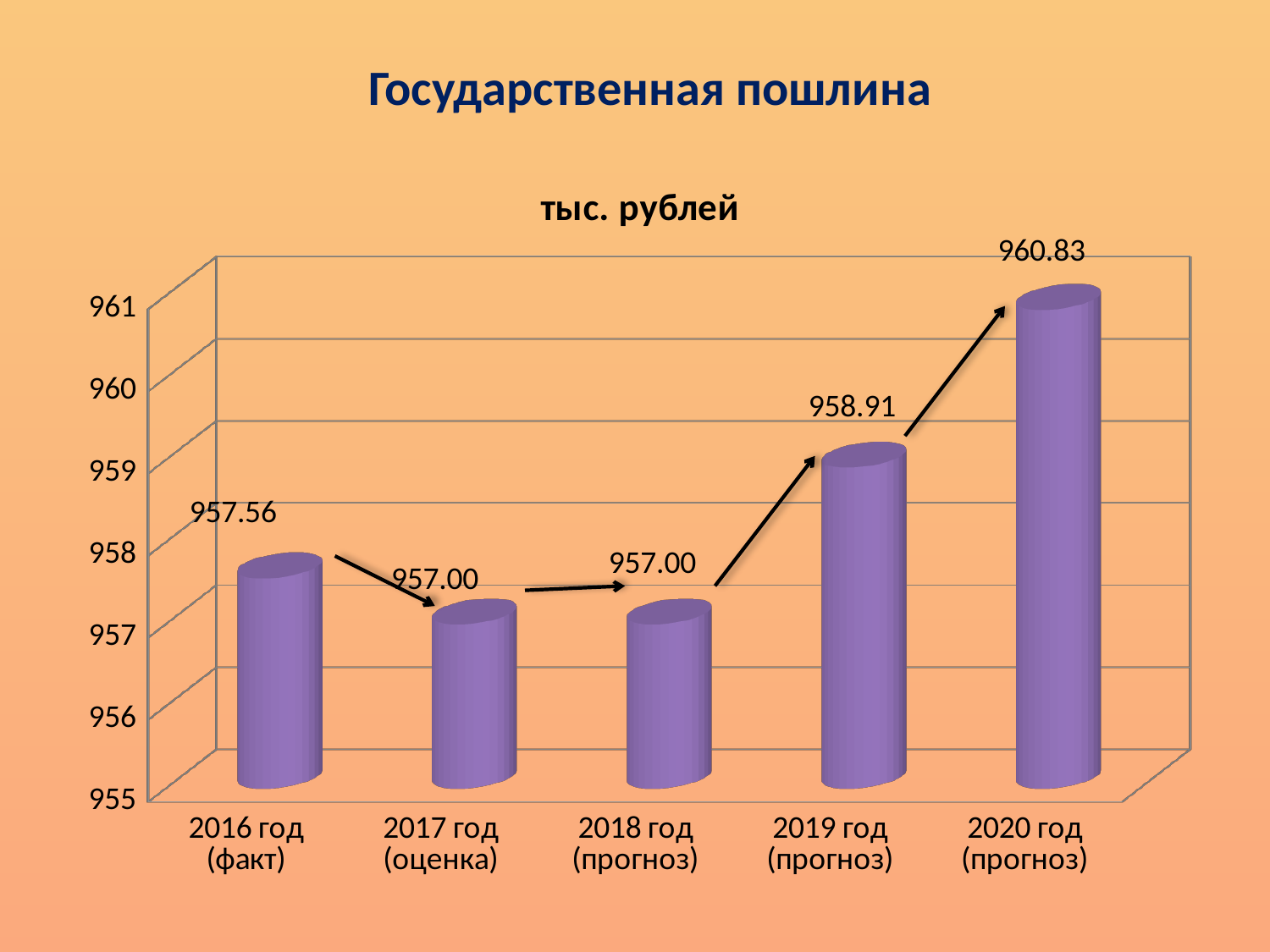
What is the value for 2016 год (факт)? 957.56 What is the difference between the values for 2016 год (факт) and 2017 год (оценка)? 0.56 What is the title of the chart? тыс. рублей What is the value for 2019 год (прогноз)? 958.91 Which year has the highest value? 2020 год (прогноз) How many categories are shown on the x axis? 5 Is the value for 2019 год (прогноз) greater or less than 958? greater What is the difference between the values for 2020 год (прогноз) and 2019 год (прогноз)? 1.92 What kind of chart is shown on the slide? bar chart Which is larger, the value for 2016 год (факт) or 2018 год (прогноз)? 2016 год (факт) What is the value for 2017 год (оценка)? 957.00 What is the value for 2020 год (прогноз)? 960.83